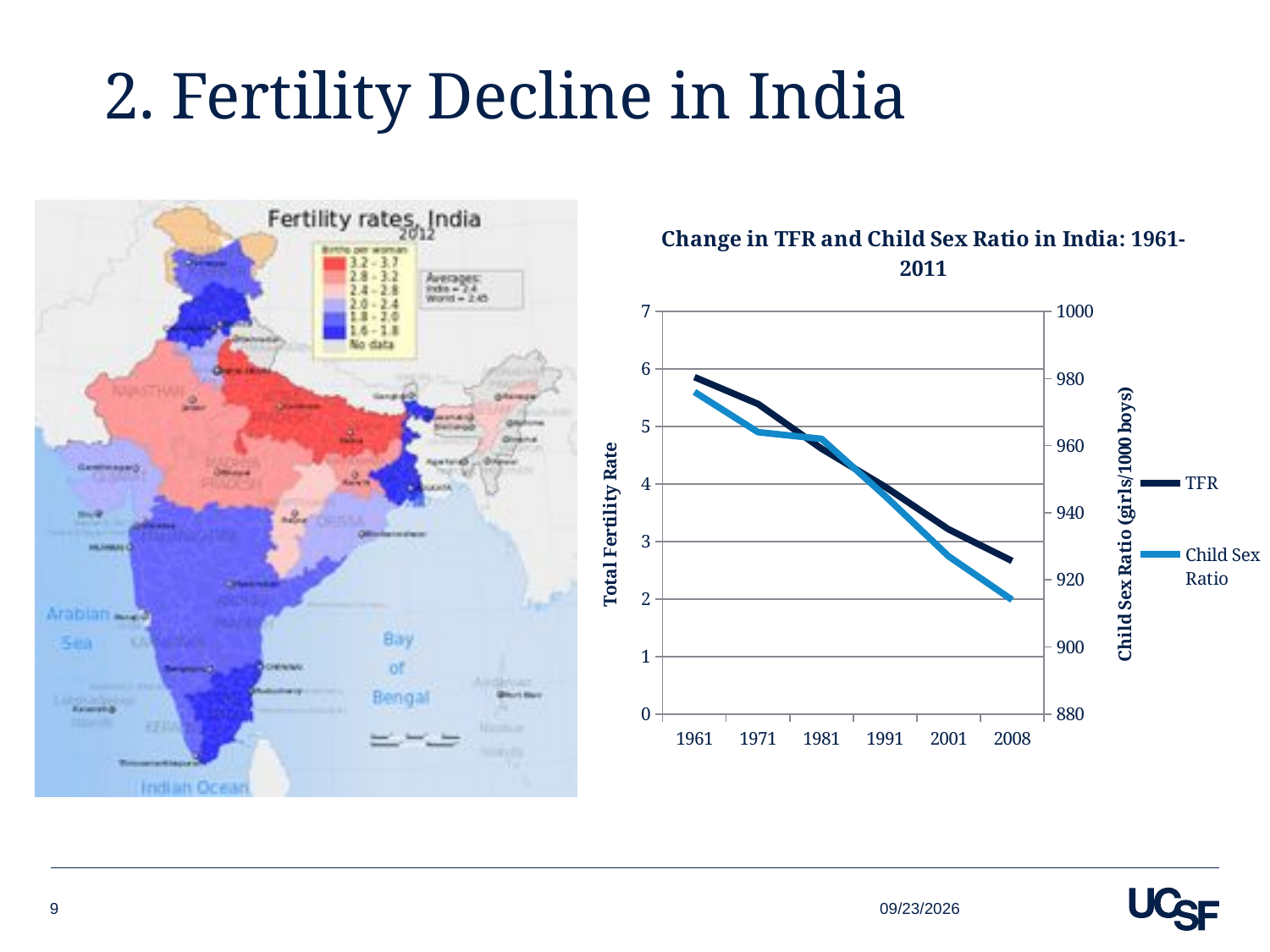
What kind of chart is 'Change in TFR and Child Sex Ratio in India: 1961-2011'? line chart How many years are marked on the x axis of the 'Change in TFR and Child Sex Ratio in India' chart? 6 What is the label of the left-hand vertical axis in the 'Change in TFR and Child Sex Ratio in India' chart? Total Fertility Rate How many series does the legend of the 'Change in TFR and Child Sex Ratio in India' chart list? 2 In the 'Change in TFR and Child Sex Ratio in India' chart, is the TFR value for 1961 greater or less than 5? greater In the 'Change in TFR and Child Sex Ratio in India' chart, does the TFR line rise or fall from 1961 to 2008? fall In the 'Change in TFR and Child Sex Ratio in India' chart, does the Child Sex Ratio line rise or fall from 1961 to 2008? fall In the 'Change in TFR and Child Sex Ratio in India' chart, is the Child Sex Ratio value for 2008 greater or less than 920? less What is the label of the right-hand vertical axis in the 'Change in TFR and Child Sex Ratio in India' chart? Child Sex Ratio (girls/1000 boys) In the 'Change in TFR and Child Sex Ratio in India' chart, is the TFR value for 2001 greater or less than 3? greater